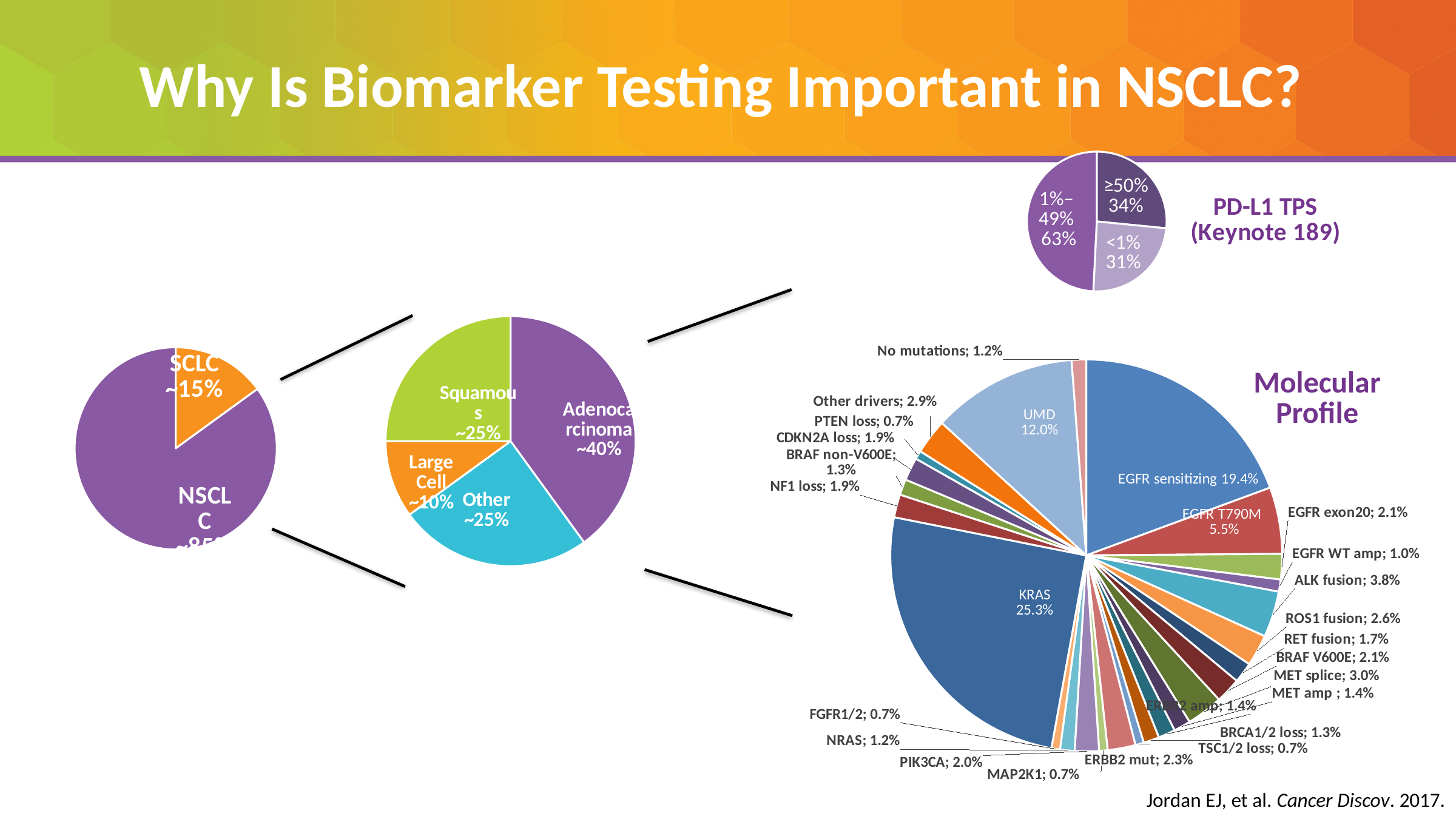
In the PD-L1 TPS (Keynote 189) chart, what share is labelled for the ≥50% slice? 34% In the middle pie chart showing NSCLC subtypes, which subtype has the smallest labelled share? Large Cell In the PD-L1 TPS (Keynote 189) chart, which slice has the largest labelled share? 1%–49% In the PD-L1 TPS (Keynote 189) chart, how many slices does the pie have? 3 In the middle pie chart showing NSCLC subtypes, how many slices does the pie have? 4 In the middle pie chart showing NSCLC subtypes, what share is labelled for Adenocarcinoma? ~40% In the Molecular Profile chart, what percentage is labelled for KRAS? 25.3% In the PD-L1 TPS (Keynote 189) chart, what share is labelled for the 1%–49% slice? 63% What kind of chart is the Molecular Profile chart? Pie chart In the Molecular Profile chart, what percentage is labelled for EGFR sensitizing? 19.4% In the Molecular Profile chart, which is larger, ALK fusion or ROS1 fusion? ALK fusion In the leftmost pie chart, what share is labelled for SCLC? ~15%